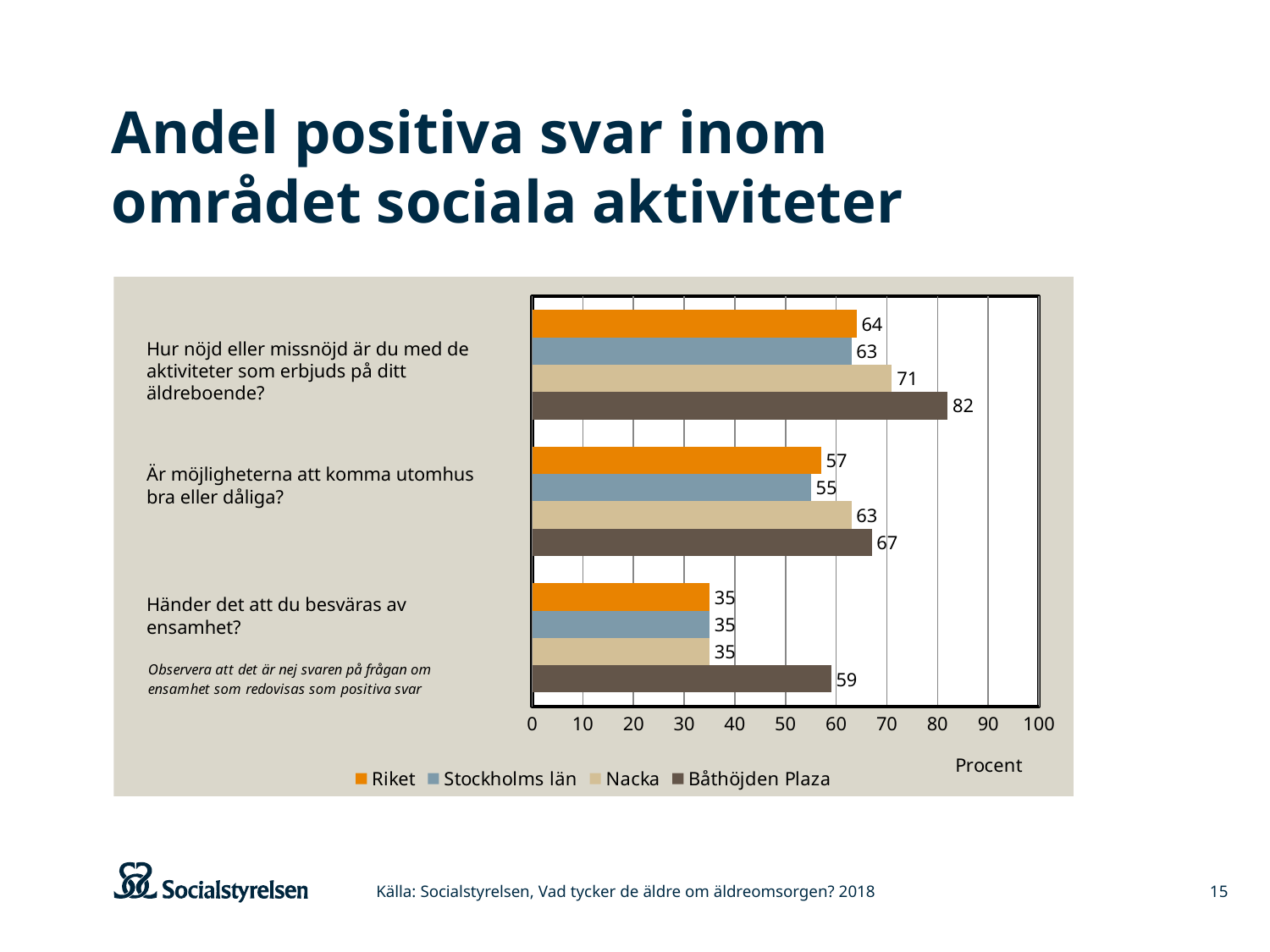
Which series has the lowest value on the question "Är möjligheterna att komma utomhus bra eller dåliga?"? Stockholms län Which series has the highest value on the question "Händer det att du besväras av ensamhet?"? Båthöjden Plaza What is the difference between Båthöjden Plaza and Riket on the question "Hur nöjd eller missnöjd är du med de aktiviteter som erbjuds på ditt äldreboende?"? 18 What type of chart is shown on the slide? bar chart What is the value for Båthöjden Plaza on the question "Hur nöjd eller missnöjd är du med de aktiviteter som erbjuds på ditt äldreboende?"? 82 What is the difference between Båthöjden Plaza and Nacka on the question "Händer det att du besväras av ensamhet?"? 24 What is the value for Nacka on the question "Är möjligheterna att komma utomhus bra eller dåliga?"? 63 What is the value for Riket on the question "Händer det att du besväras av ensamhet?"? 35 How many question categories are plotted on the chart? 3 Which is larger on the question "Är möjligheterna att komma utomhus bra eller dåliga?": Riket or Nacka? Nacka How many series does the legend list? 4 What label is shown on the horizontal axis of the chart? Procent